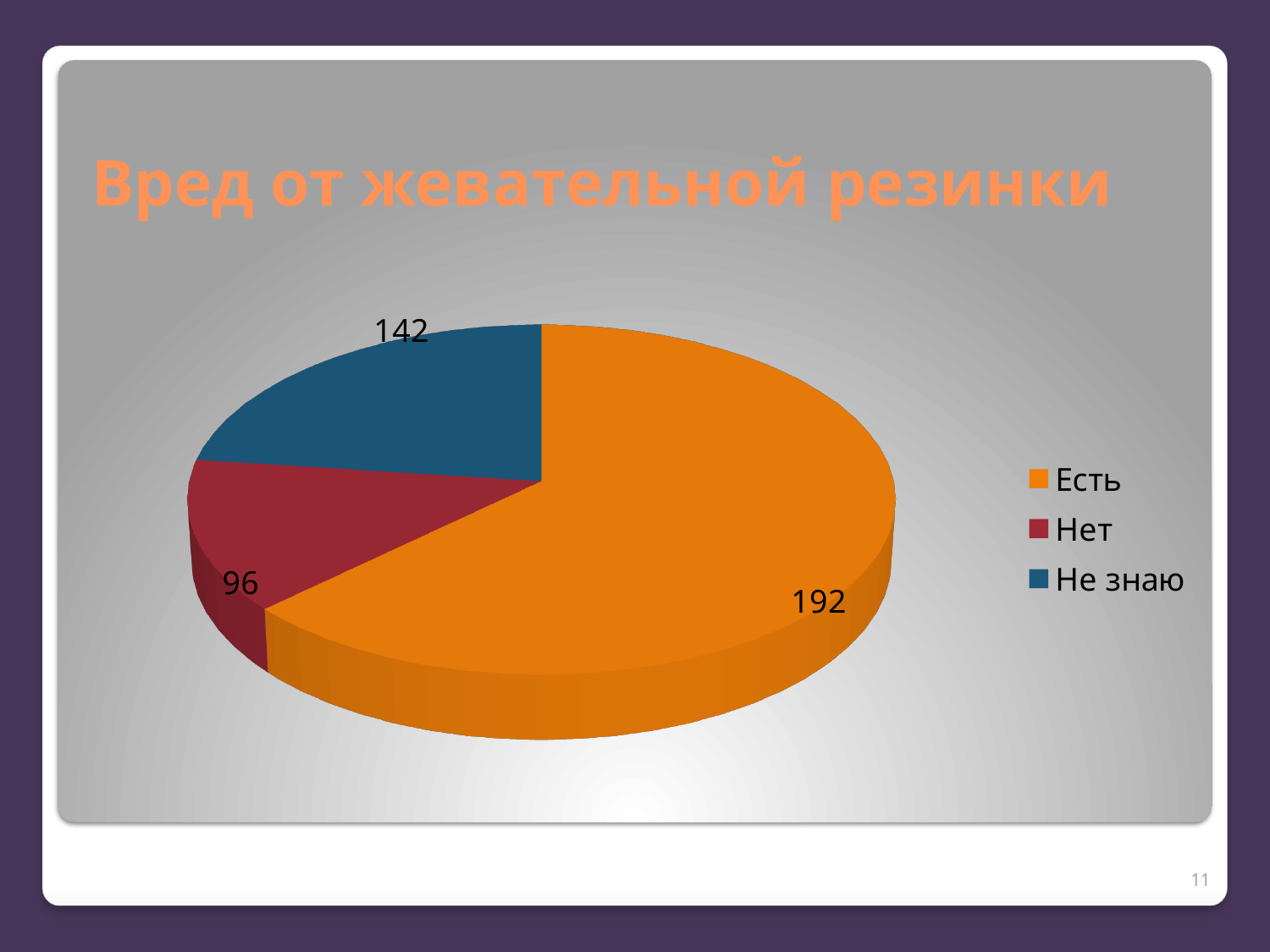
What is the value for the "Нет" slice? 96 What is the difference between the values for "Есть" and "Не знаю"? 50 What is the title of the chart? Вред от жевательной резинки What is the difference between the values for "Есть" and "Нет"? 96 What type of chart is shown on the slide? pie chart What is the total of all slices in the pie chart? 430 What is the value for the "Есть" slice? 192 Which category has the smallest slice? Нет Which is larger, the value for "Не знаю" or the value for "Нет"? Не знаю How many categories does the legend list? 3 Which category has the largest slice? Есть What is the value for the "Не знаю" slice? 142